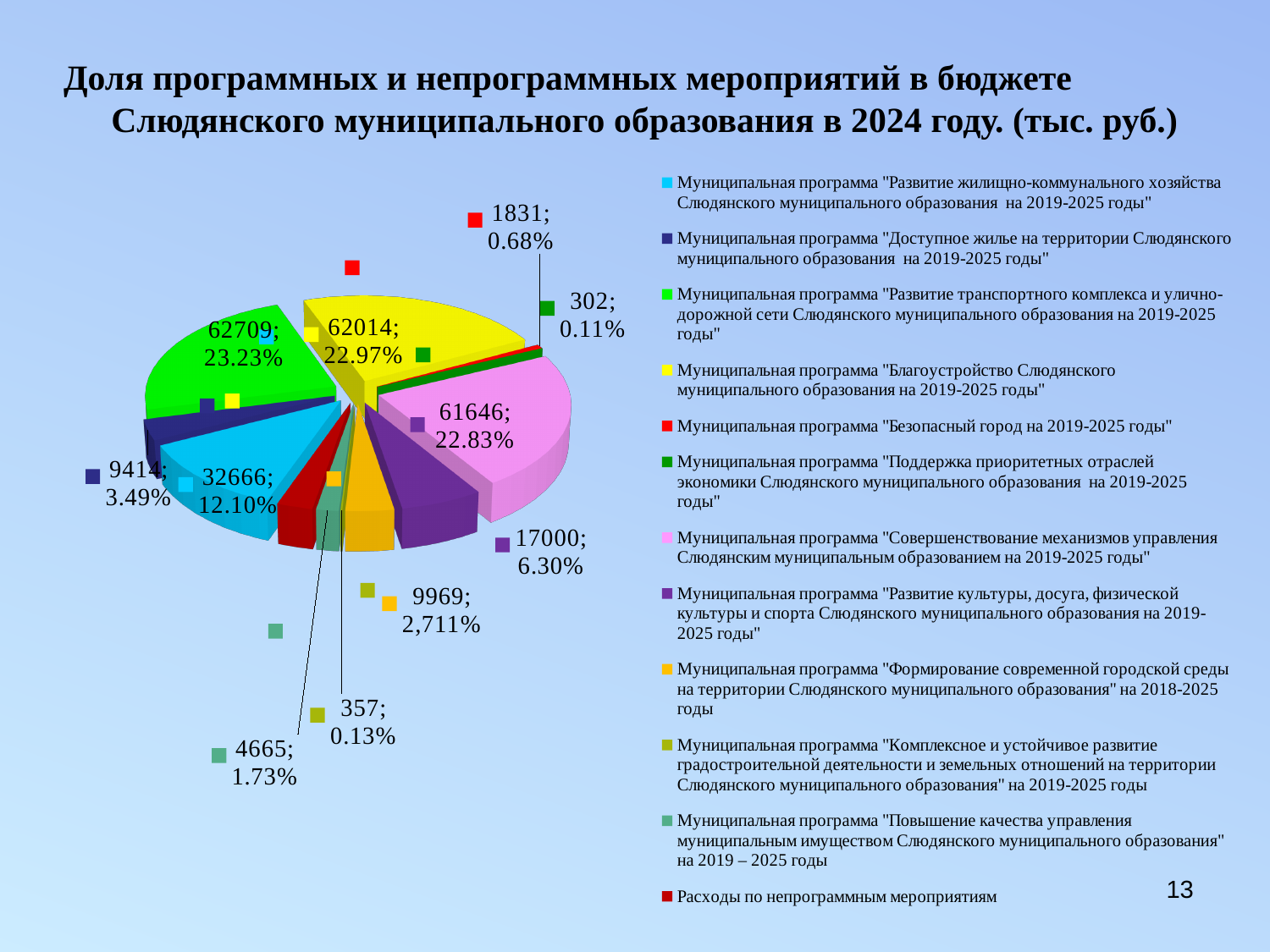
How many entries does the legend list? 12 Which programme has the smallest value in the pie chart? Поддержка приоритетных отраслей экономики (302; 0.11%) What percentage share is shown for the municipal programme "Благоустройство Слюдянского муниципального образования" (yellow slice)? 22.97% Which is larger: the value for "Совершенствование механизмов управления" (pink) or "Развитие жилищно-коммунального хозяйства" (cyan)? Совершенствование механизмов управления (61646) What value is shown for the municipal programme "Развитие культуры, досуга, физической культуры и спорта" (purple slice)? 17000 What type of chart is shown on the slide? Pie chart What value is shown for the programme "Повышение качества управления муниципальным имуществом" (sea-green slice)? 4665 What value and share are shown for the programme "Безопасный город" (red slice)? 1831; 0.68% What value is shown for the municipal programme "Развитие жилищно-коммунального хозяйства" (cyan slice)? 32666 Which programme has the largest value in the pie chart? Развитие транспортного комплекса и улично-дорожной сети (62709; 23.23%) What percentage share is shown for the programme "Доступное жилье" (dark blue slice)? 3.49% What is the difference between the value for "Развитие транспортного комплекса" (62709) and "Благоустройство" (62014)? 695